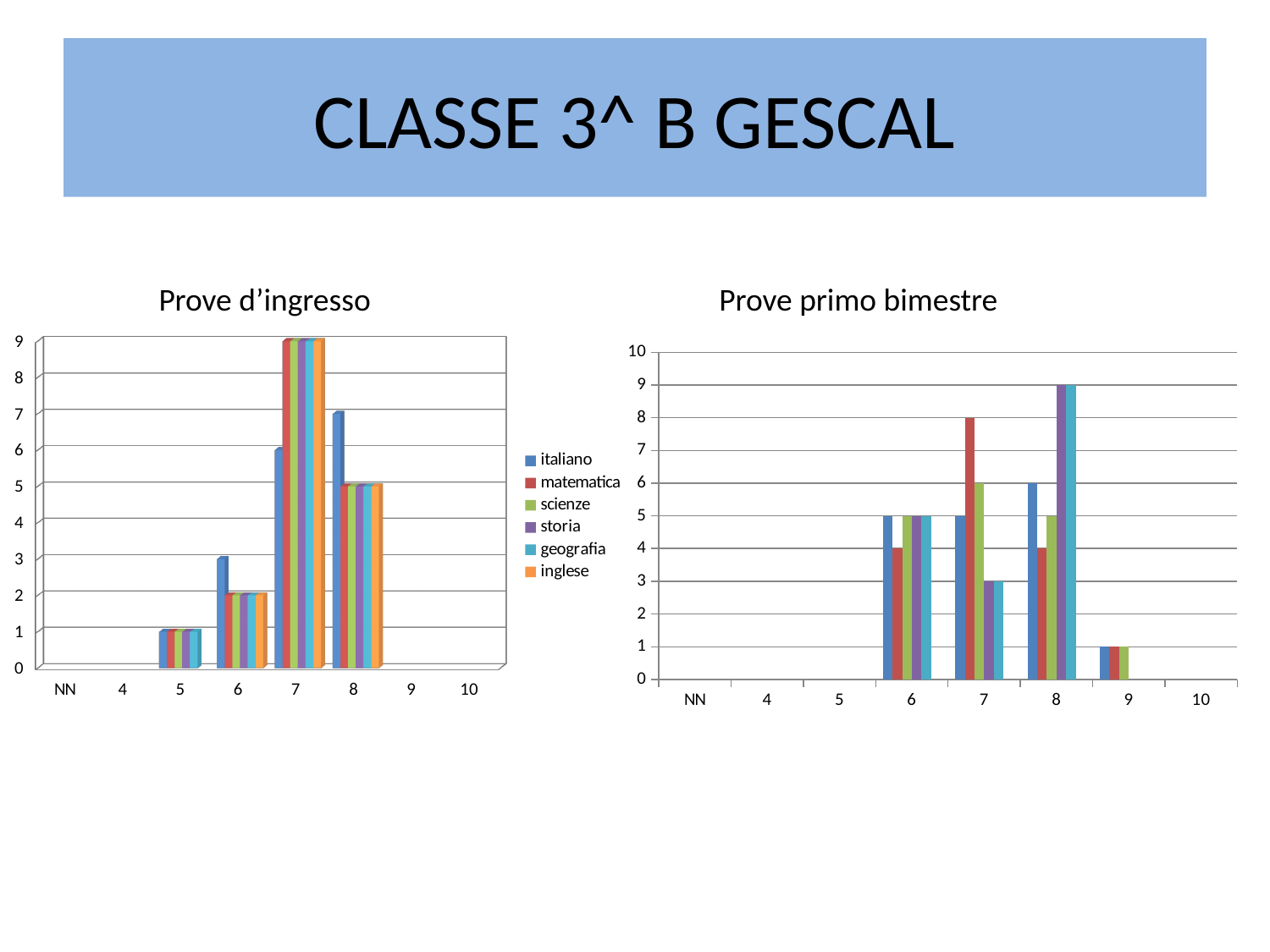
How many series does the legend list? 6 In the 'Prove primo bimestre' chart, at which category is the matematica bar highest? 7 In the 'Prove d’ingresso' chart, what is the difference between italiano and scienze at category 6? 1 In the 'Prove primo bimestre' chart, is the value for italiano at category 8 greater or less than 5? greater How many categories are shown on the x axis of the 'Prove d’ingresso' chart? 8 In the 'Prove d’ingresso' chart, what is the value for italiano at category 8? 7 In the 'Prove d’ingresso' chart, what is the value for matematica at category 7? 9 In the 'Prove primo bimestre' chart, what is the value for storia at category 8? 9 What kind of chart is the 'Prove d’ingresso' chart? bar chart In the 'Prove primo bimestre' chart, at category 7, which is larger: matematica or storia? matematica In the 'Prove d’ingresso' chart, what is the value for italiano at category 7? 6 In the 'Prove primo bimestre' chart, what is the value for matematica at category 7? 8